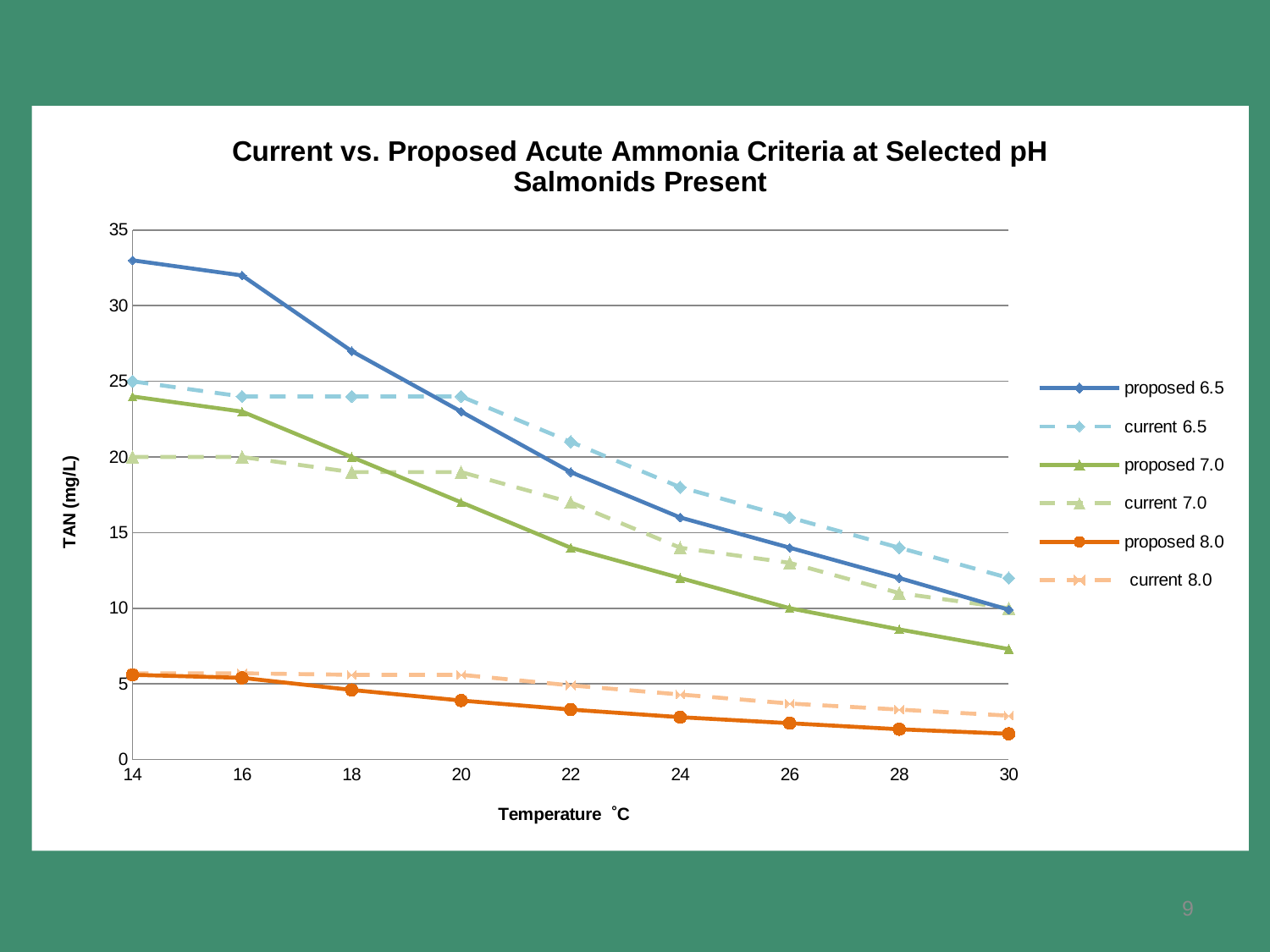
Is the value for proposed 8.0 at 30 °C greater or less than 5? less Which series has the highest value at 14 °C? proposed 6.5 Is the value for proposed 6.5 at 14 °C greater or less than 30? greater Which series is drawn with a solid orange line with circle markers? proposed 8.0 How many temperature points are plotted along the x axis? 9 Which series has the lowest value at 30 °C? proposed 8.0 Is the value for current 6.5 at 22 °C greater or less than 20? greater At 26 °C, which is larger: current 6.5 or proposed 7.0? current 6.5 What is the label of the y axis? TAN (mg/L) Do the values for the proposed 6.5 series rise or fall as temperature increases? fall What kind of chart is shown on the slide? line chart How many series does the legend list? 6